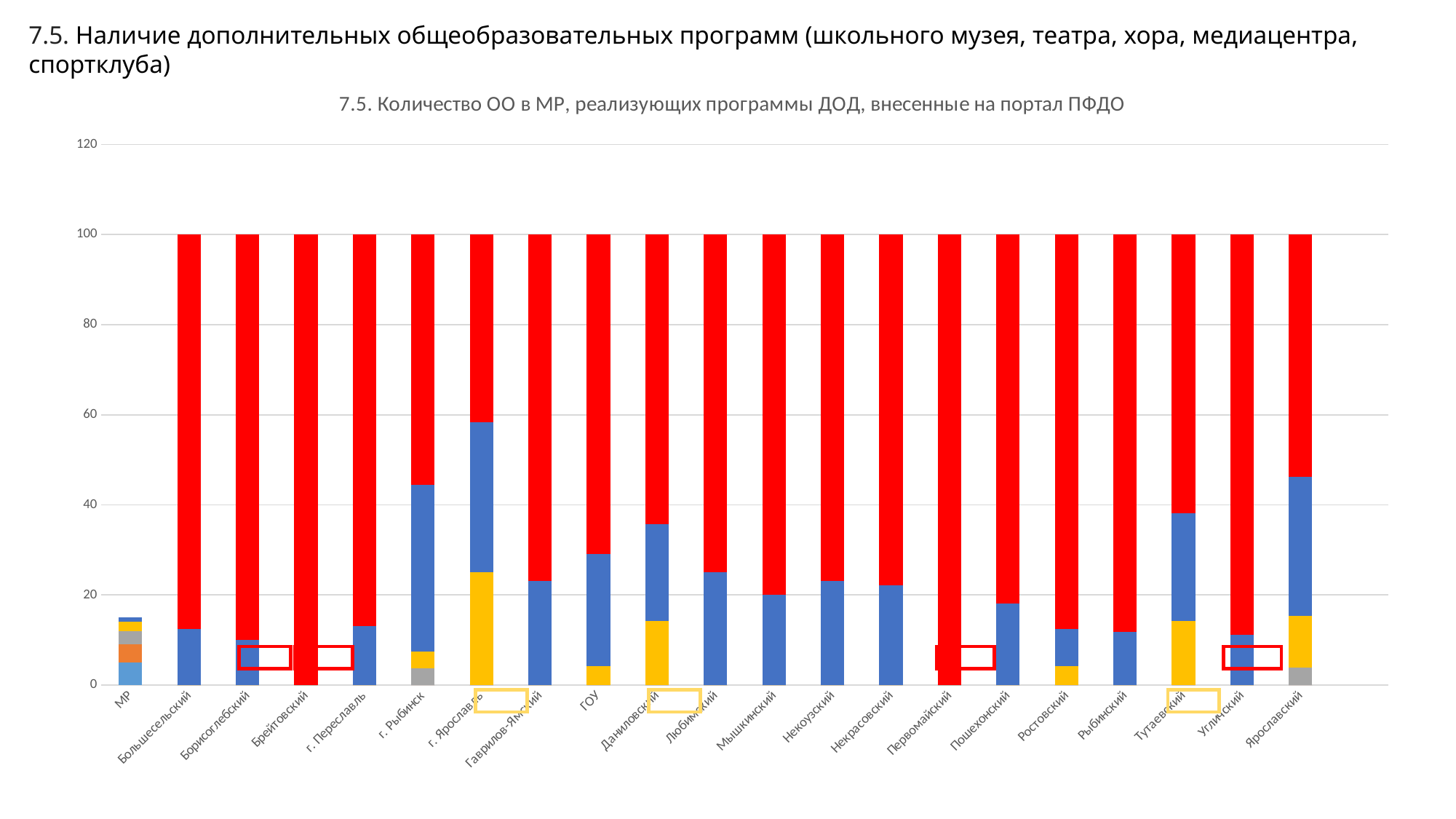
Which category has the largest yellow segment? г. Ярославль What is the total height of the stacked bar for Большесельский? 100 Which category has the shortest bar overall? МР What is the title of the chart? 7.5. Количество ОО в МР, реализующих программы ДОД, внесенные на портал ПФДО What kind of chart is shown on the slide? Stacked bar chart Is the top of the blue segment for г. Ярославль greater or less than 40? greater Is the top of the blue segment for Мышкинский greater or less than 40? less Is the top of the blue segment for Тутаевский greater or less than 20? greater What colour is the topmost segment of the stacked bars? Red How many categories are shown along the x axis of the chart? 21 What is the total height of the stacked bar for Ярославский? 100 Does the blue segment reach higher for г. Ярославль or for Гаврилов-Ямский? г. Ярославль